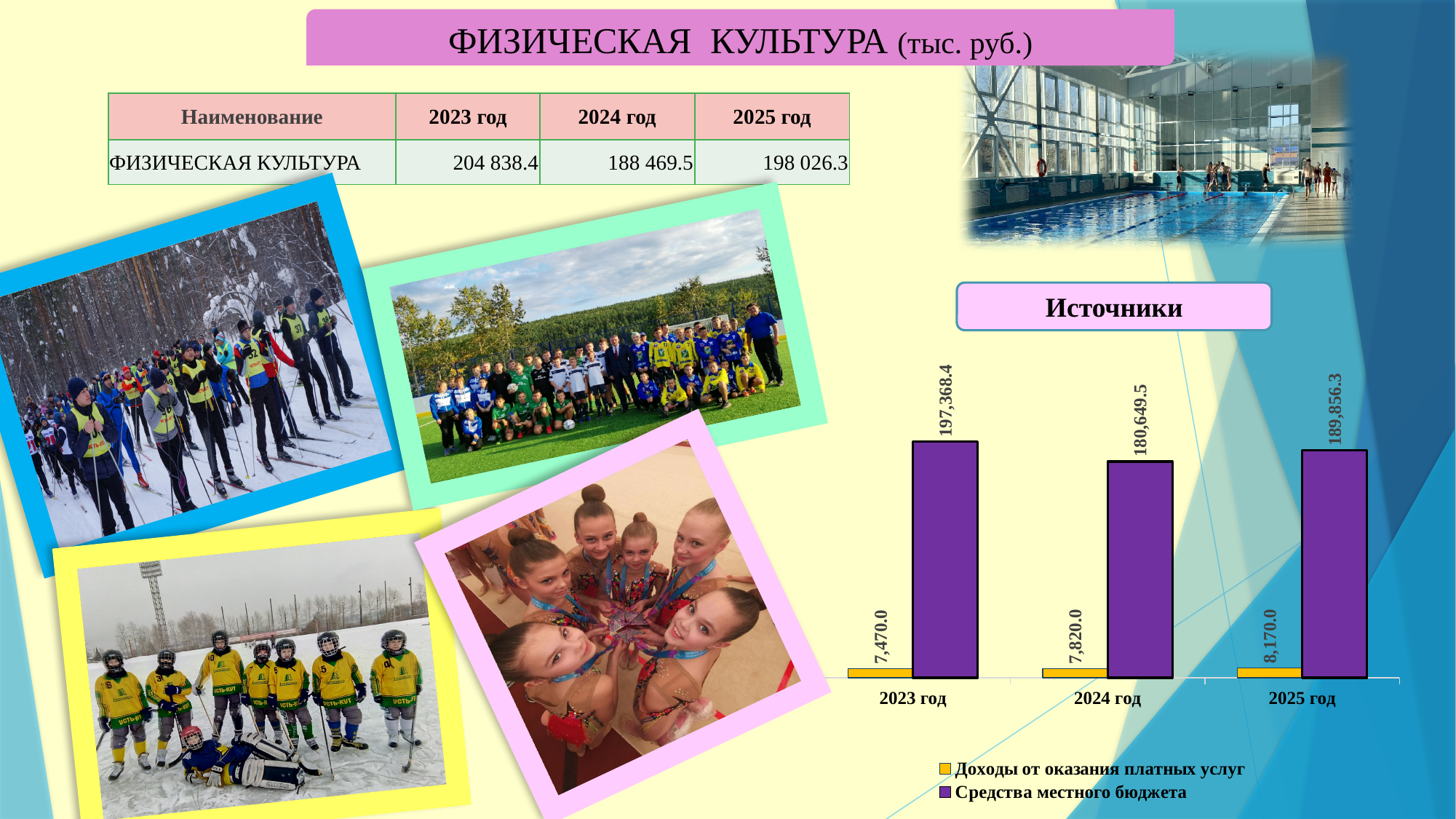
In the "Источники" chart, what is the value of "Средства местного бюджета" for 2024 год? 180,649.5 How many series does the legend of the "Источники" chart list? 2 In the "Источники" chart, which year has the lowest value for "Доходы от оказания платных услуг"? 2023 год In the "Источники" chart, which colour represents "Средства местного бюджета"? purple In the "Источники" chart, do the values for "Доходы от оказания платных услуг" rise or fall from 2023 год to 2025 год? rise In the "Источники" chart, what is the value of "Средства местного бюджета" for 2023 год? 197,368.4 In the "Источники" chart, what is the difference between "Доходы от оказания платных услуг" in 2024 год and 2023 год? 350.0 What type of chart is shown under the heading "Источники"? bar chart In the "Источники" chart, which year has the highest value for "Средства местного бюджета"? 2023 год In the "Источники" chart, what is the value of "Доходы от оказания платных услуг" for 2025 год? 8,170.0 How many year categories are shown on the x axis of the "Источники" chart? 3 In the "Источники" chart, is "Средства местного бюджета" larger in 2025 год or in 2024 год? 2025 год